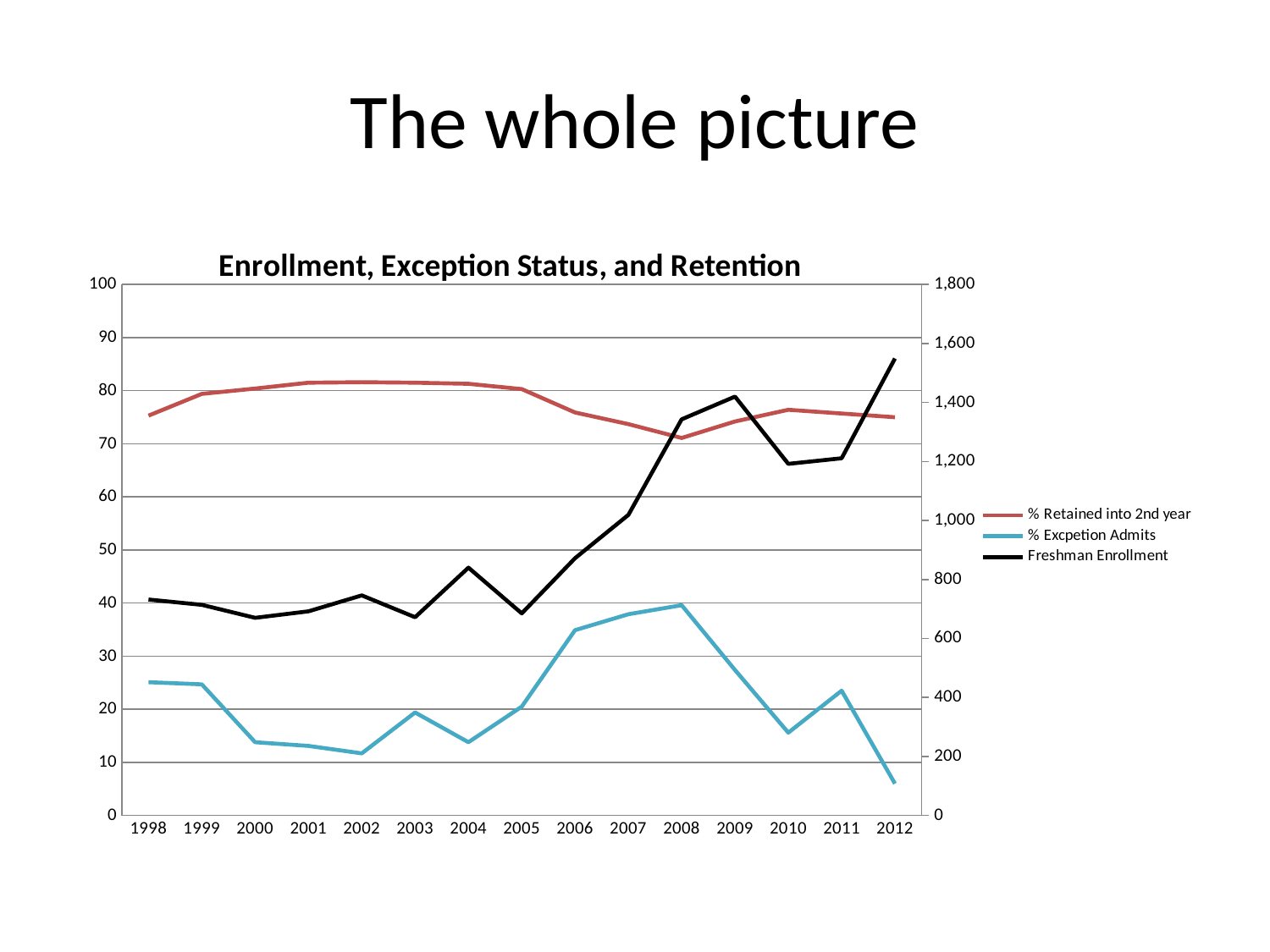
Which series is drawn with a black line? Freshman Enrollment How many series does the legend list? 3 Is the % Excpetion Admits value for 2012 greater or less than 10? less What is the title of the chart? Enrollment, Exception Status, and Retention Does Freshman Enrollment rise or fall from 2005 to 2009? rise Which year has the larger % Excpetion Admits value, 2000 or 2006? 2006 Is the Freshman Enrollment value for 2012 greater or less than 1,400? greater What kind of chart is shown on the slide? Line chart In which year is % Excpetion Admits lowest? 2012 How many years are plotted along the x axis? 15 In which year is Freshman Enrollment highest? 2012 Is the Freshman Enrollment value for 1998 greater or less than 800? less